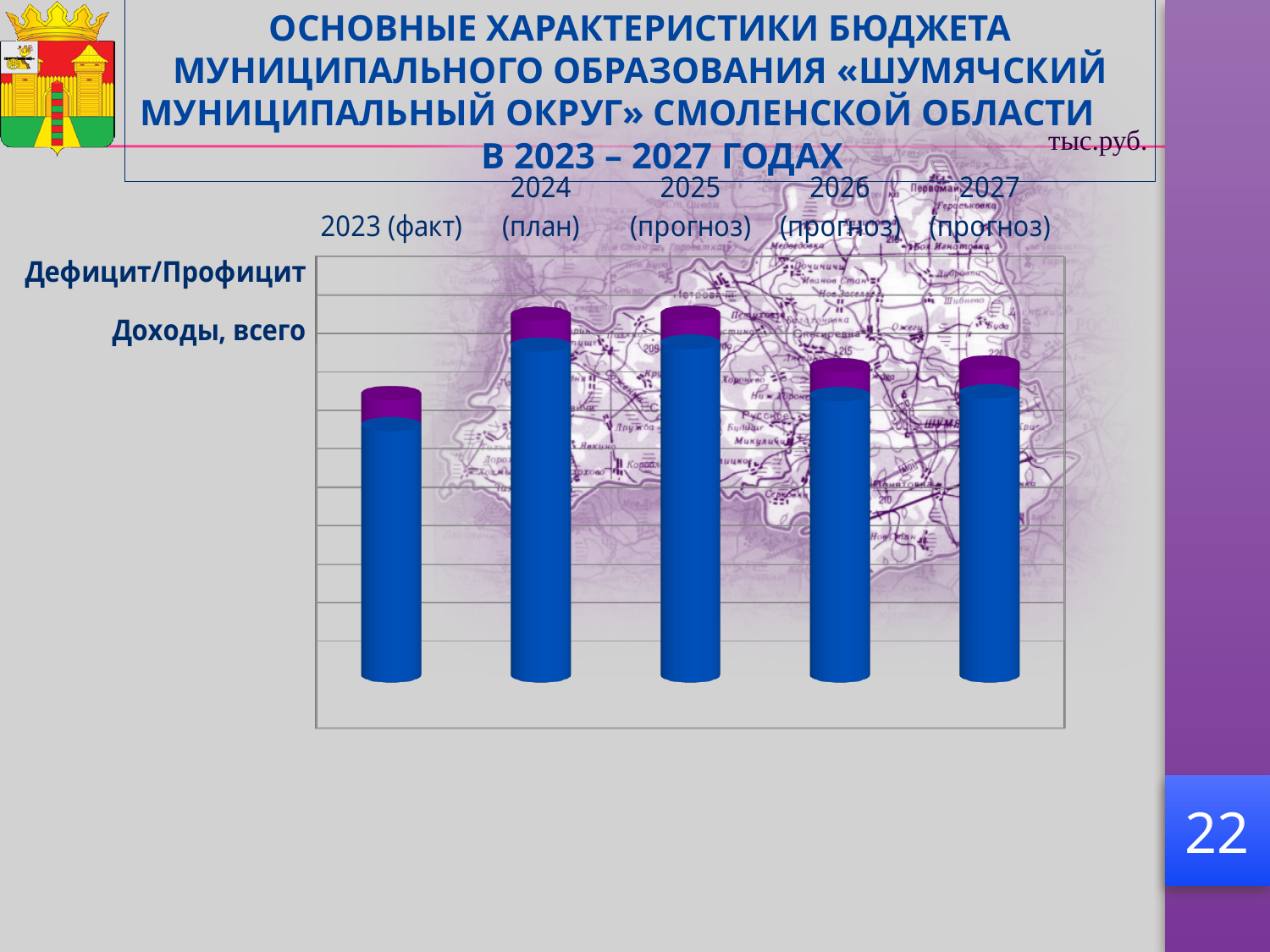
What unit of measurement is indicated for the chart values? тыс.руб. Which is larger, the bar for 2023 (факт) or the bar for 2024 (план)? 2024 (план) Does the bar height rise or fall from 2023 (факт) to 2024 (план)? rise How many year categories are plotted on the chart? 5 What kind of chart is shown on the slide? bar chart Does the bar height rise or fall from 2025 (прогноз) to 2026 (прогноз)? fall Which is larger, the bar for 2025 (прогноз) or the bar for 2026 (прогноз)? 2025 (прогноз) Which year has the lowest total bar on the chart? 2023 (факт)